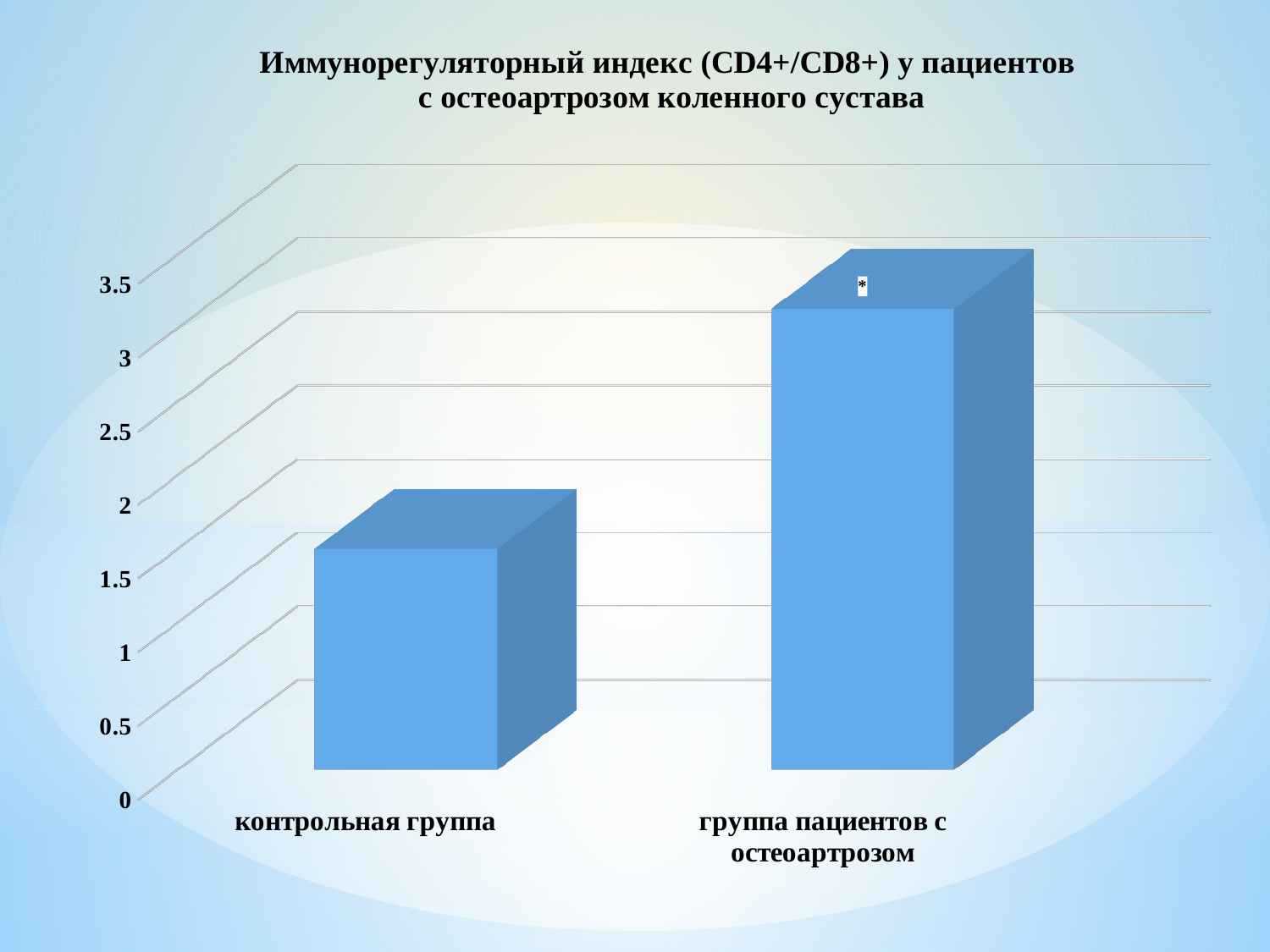
Is the value for группа пациентов с остеоартрозом greater or less than 2.5? greater Which group has the lowest immunoregulatory index on the chart? контрольная группа Which group has the highest immunoregulatory index on the chart? группа пациентов с остеоартрозом What is the highest value shown on the vertical axis? 3.5 What kind of chart is shown on the slide? bar chart Is the value for группа пациентов с остеоартрозом greater or less than 3.5? less What is the title of the chart? Иммунорегуляторный индекс (CD4+/CD8+) у пациентов с остеоартрозом коленного сустава Do the values rise or fall from the left bar to the right bar? rise Is the value for контрольная группа greater or less than 2? less How many categories (groups) are plotted on the chart? 2 Which is larger: the value for контрольная группа or the value for группа пациентов с остеоартрозом? группа пациентов с остеоартрозом